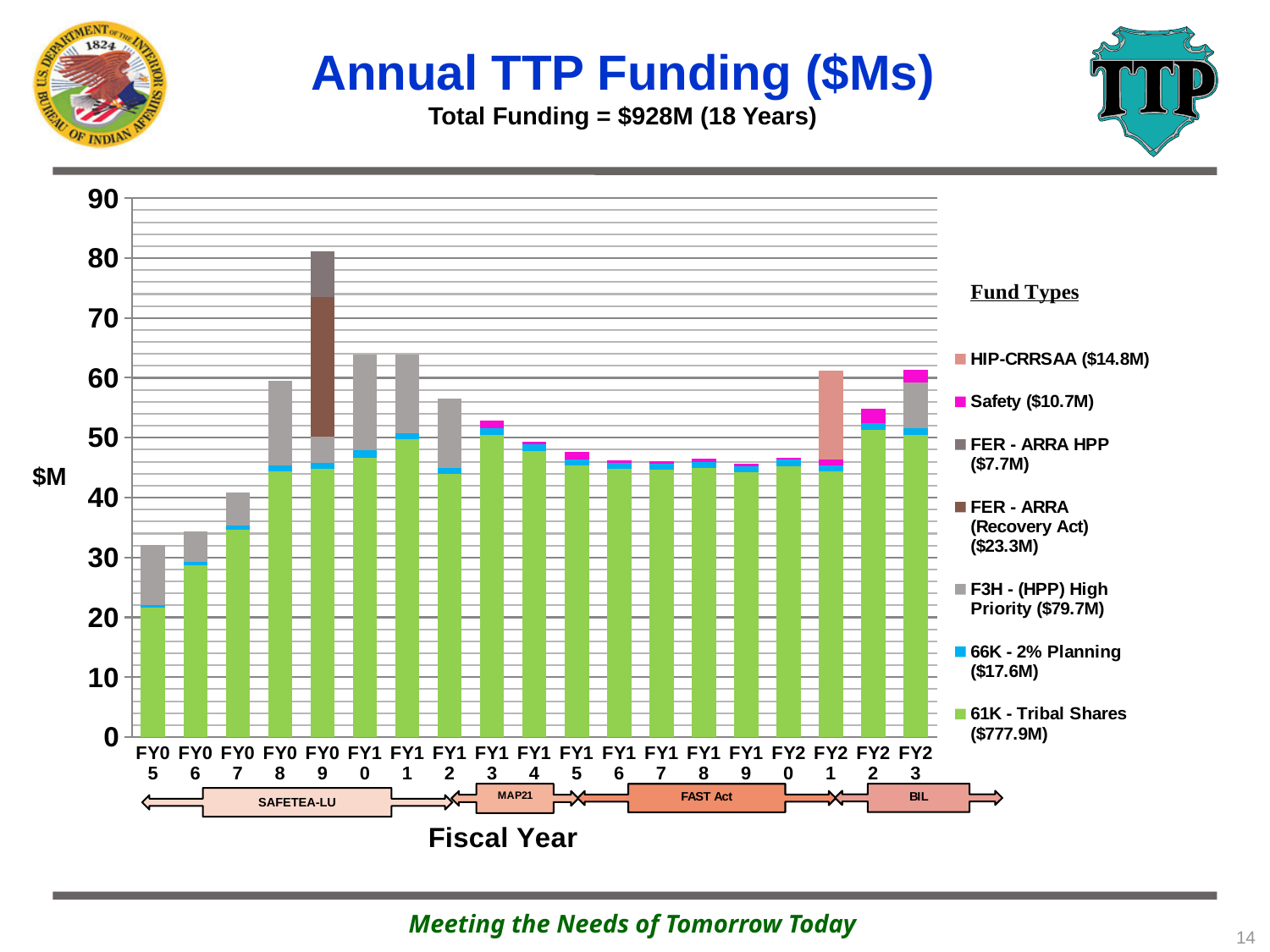
Which fiscal year has the lowest total funding bar? FY05 Is the total funding bar for FY05 greater or less than 40? less Which has the taller total funding bar, FY09 or FY10? FY09 Do the total funding bars rise or fall from FY05 to FY09? rise According to the legend, what is the total for 61K - Tribal Shares? $777.9M How many fiscal years are shown along the x axis of the chart? 19 Is the total funding bar for FY15 greater or less than 50? less Is the total funding bar for FY10 greater or less than 60? greater Which fiscal year has the highest total funding bar? FY09 What kind of chart is shown on the slide? Stacked bar chart How many fund types does the legend list? 7